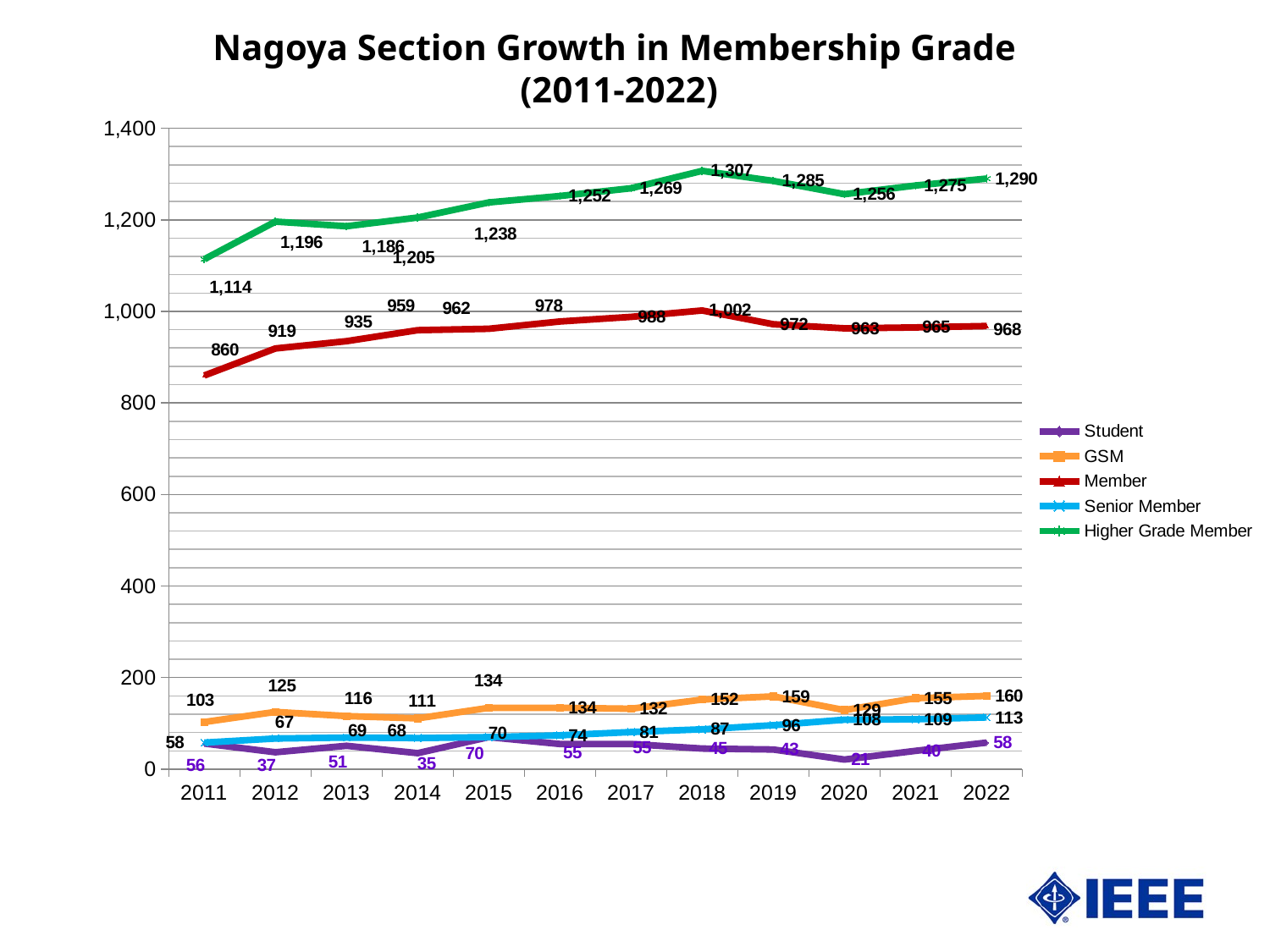
What is the Member value for 2011? 860 What is the Higher Grade Member value for 2018? 1,307 How many series does the legend list? 5 What is the GSM value for 2022? 160 By how much did the Member value increase from 2011 to 2022? 108 What type of chart is shown on the slide? Line chart What is the title of the chart? Nagoya Section Growth in Membership Grade (2011-2022) In which year does the Higher Grade Member series reach its highest value? 2018 How many years are plotted along the x axis? 12 In which year is the Member series at its lowest value? 2011 Does the Senior Member series generally rise or fall from 2011 to 2022? Rise In 2022, which is larger: GSM or Senior Member? GSM